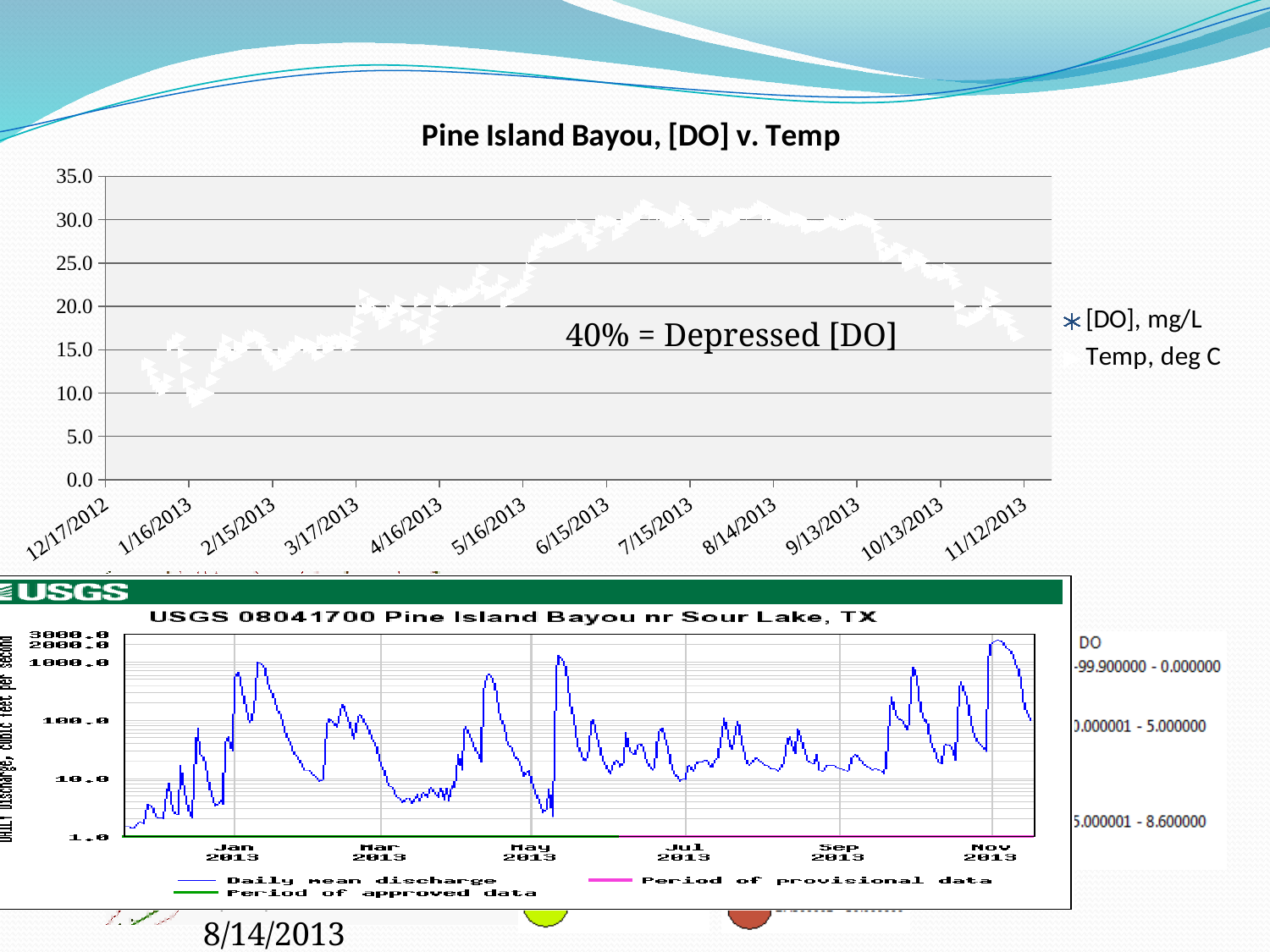
In the top chart, is the Temp, deg C value larger around 8/14/2013 or around 1/16/2013? 8/14/2013 In the top chart, is the Temp, deg C value around 7/15/2013 greater or less than 25.0? greater How many series does the legend of the top chart list? 2 In the top chart, does the Temp, deg C series rise or fall between 1/16/2013 and 7/15/2013? rise What is the title of the top chart? Pine Island Bayou, [DO] v. Temp How many entries does the legend of the bottom USGS chart list? 3 In the top chart, is the Temp, deg C value around 1/16/2013 greater or less than 20.0? less How many date labels are shown on the x axis of the top chart? 12 What kind of chart is the bottom USGS chart? line chart What is the title of the bottom USGS chart? USGS 08041700 Pine Island Bayou nr Sour Lake, TX In the bottom USGS chart, is the peak daily mean discharge in Nov 2013 greater or less than 1000.0? greater What kind of chart is the top chart, 'Pine Island Bayou, [DO] v. Temp'? scatter chart